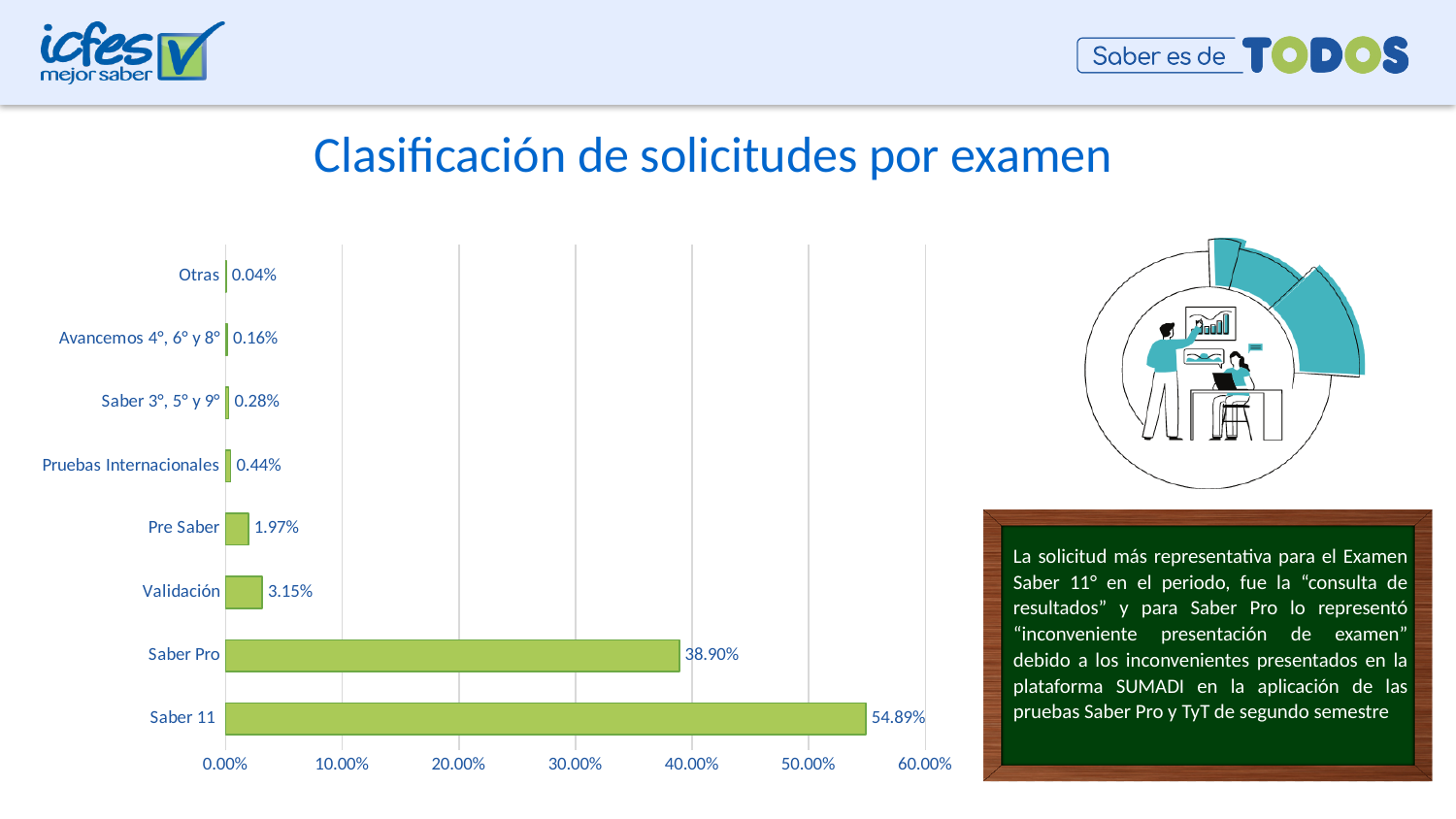
What is the value for Validación? 3.15% What is the value for Pruebas Internacionales? 0.44% Which is larger, the value for Pre Saber or the value for Validación? Validación What kind of chart is shown on the slide? bar chart Which category has the lowest value? Otras What is the difference between the values for Saber 11 and Saber Pro? 15.99% How many categories are shown in the chart? 8 What is the value for Saber Pro? 38.90% Is the value for Saber Pro greater or less than 40.00%? less What is the title of the chart? Clasificación de solicitudes por examen What is the value for Saber 11? 54.89% Which category has the highest value? Saber 11